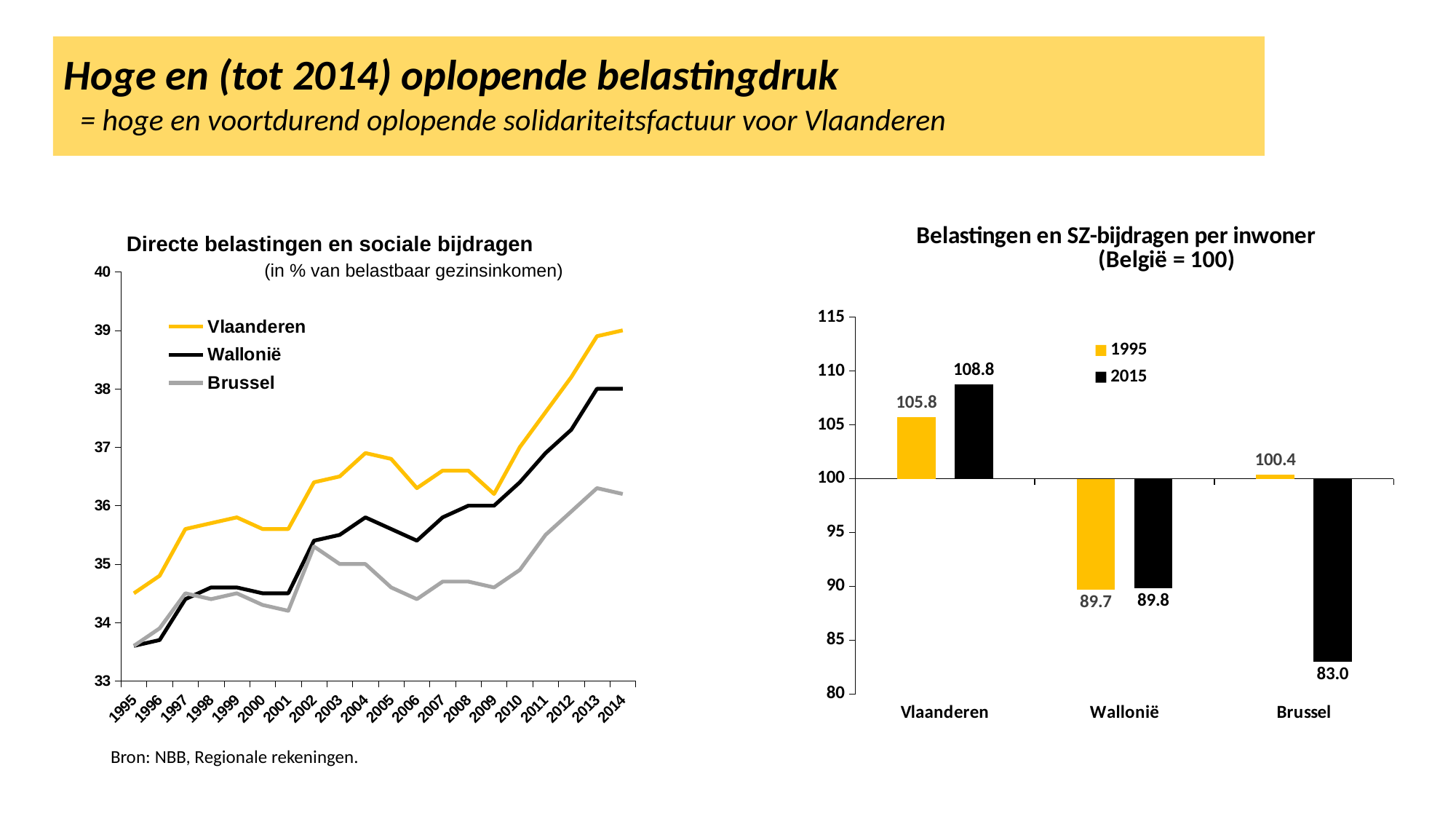
In the chart 'Directe belastingen en sociale bijdragen', does the Vlaanderen line generally rise or fall from 1995 to 2014? Rise In the chart 'Belastingen en SZ-bijdragen per inwoner', what is the value for Vlaanderen in 2015? 108.8 What kind of chart is 'Belastingen en SZ-bijdragen per inwoner'? Bar chart How many series does the legend of the chart 'Belastingen en SZ-bijdragen per inwoner' list? 2 In the chart 'Belastingen en SZ-bijdragen per inwoner', what is the difference between the 2015 and 1995 values for Vlaanderen? 3.0 In the chart 'Belastingen en SZ-bijdragen per inwoner', which region has the highest value in 1995? Vlaanderen In the chart 'Belastingen en SZ-bijdragen per inwoner', what is the value for Brussel in 1995? 100.4 In the chart 'Belastingen en SZ-bijdragen per inwoner', which is larger for Brussel: the 1995 value or the 2015 value? 1995 In the chart 'Directe belastingen en sociale bijdragen', is the value for Vlaanderen in 2014 greater or less than 38? greater In the chart 'Belastingen en SZ-bijdragen per inwoner', which region has the lowest value in 2015? Brussel How many series does the legend of the chart 'Directe belastingen en sociale bijdragen' list? 3 What kind of chart is 'Directe belastingen en sociale bijdragen'? Line chart